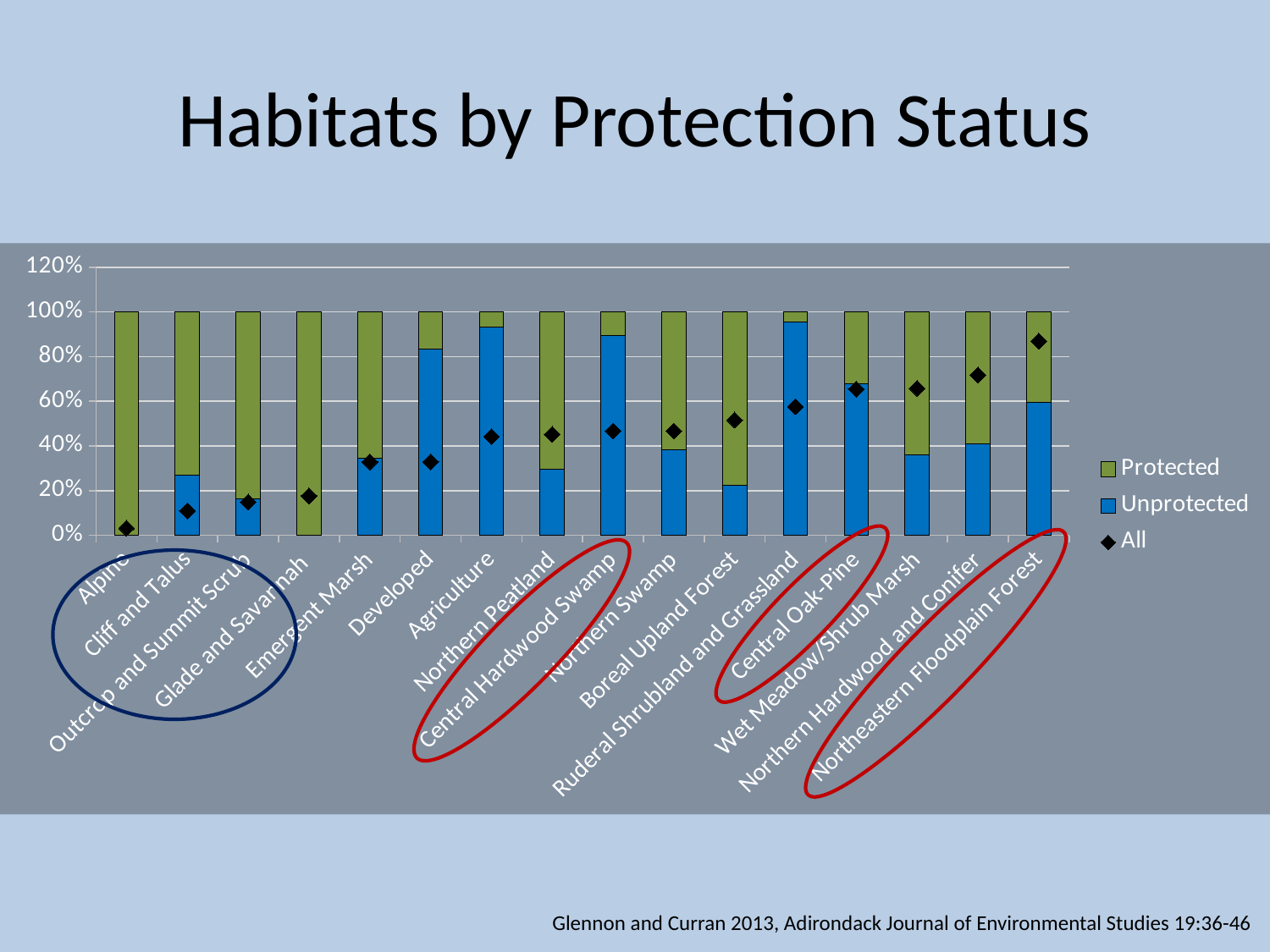
Which has the larger Unprotected share, Agriculture or Northern Peatland? Agriculture What kind of chart is shown on the slide? Stacked bar chart What is the title of the chart? Habitats by Protection Status Is the Unprotected value for Northern Peatland greater or less than 40%? less Is the Unprotected value for Alpine greater or less than 20%? less Do the All markers generally rise or fall from left to right along the x axis? Rise Is the All marker for Northeastern Floodplain Forest greater or less than 80%? greater How many habitat categories are plotted along the x axis? 16 How many series does the legend list? 3 Which colour represents the Protected series? Green